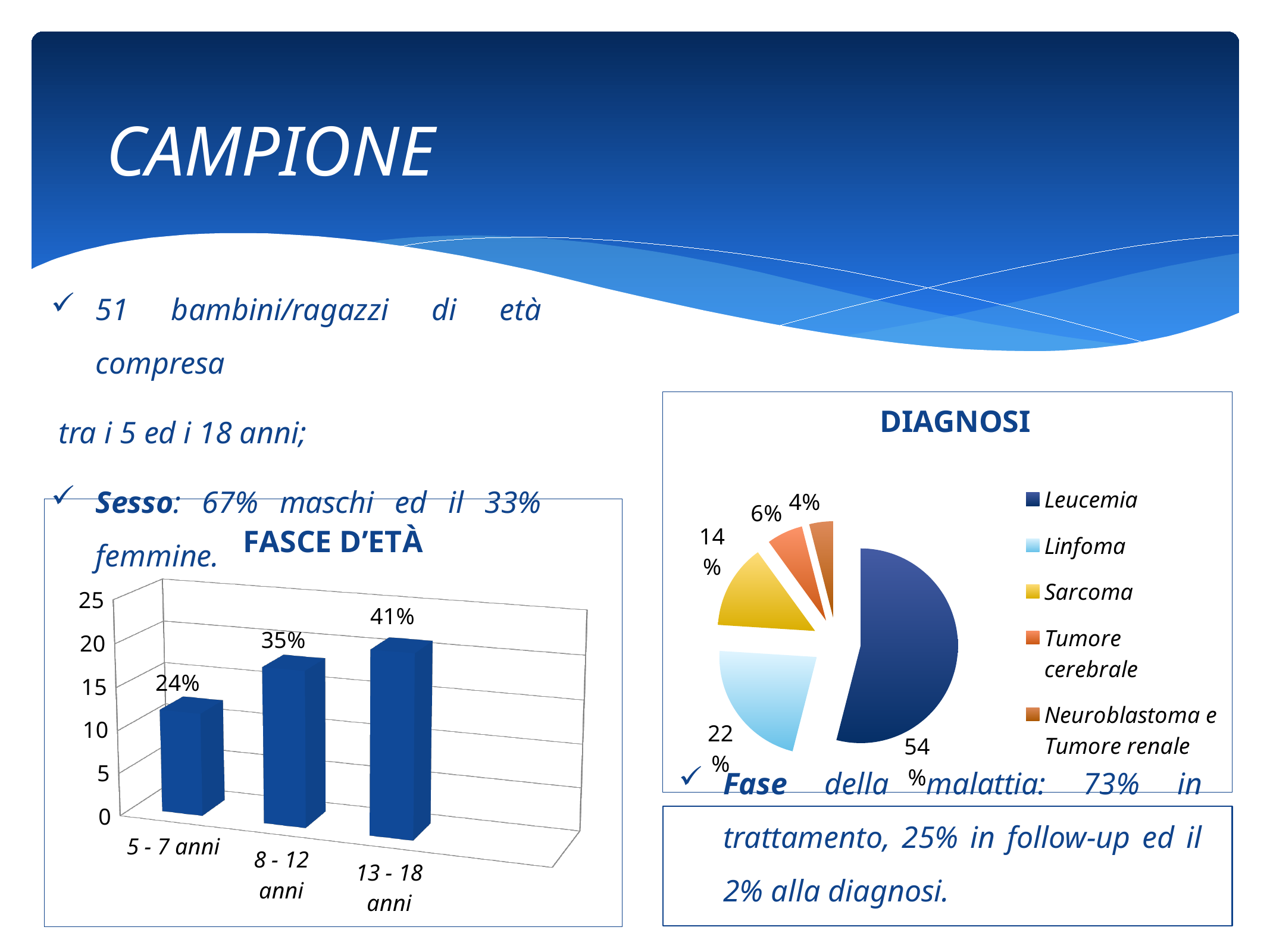
In the DIAGNOSI chart, which diagnosis has the smallest slice? Neuroblastoma e Tumore renale In the FASCE D'ETÀ chart, which age group has the highest value? 13 - 18 anni In the FASCE D'ETÀ chart, which age group has the lowest value? 5 - 7 anni In the FASCE D'ETÀ chart, do the values rise or fall from 5 - 7 anni to 13 - 18 anni? rise In the FASCE D'ETÀ chart, what is the data label for the 13 - 18 anni bar? 41% In the FASCE D'ETÀ chart, how many age groups are shown? 3 In the DIAGNOSI chart, which is larger, Linfoma or Tumore cerebrale? Linfoma In the DIAGNOSI chart, how many entries does the legend list? 5 In the DIAGNOSI chart, what share does Sarcoma have? 14% In the FASCE D'ETÀ chart, what is the data label for the 5 - 7 anni bar? 24% What kind of chart is the FASCE D'ETÀ chart? bar chart In the DIAGNOSI chart, what share does Leucemia have? 54%